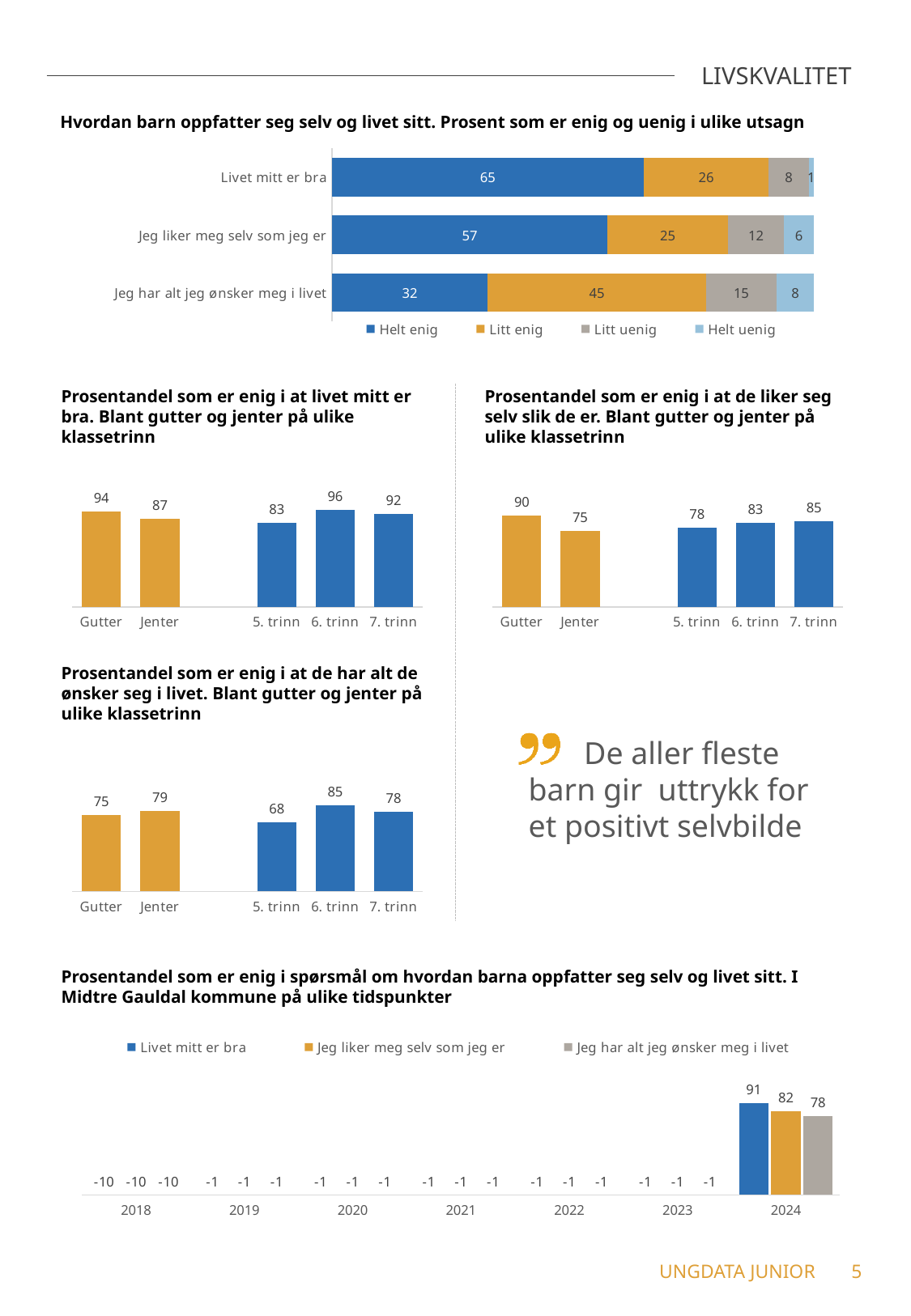
In the chart 'Prosentandel som er enig i at livet mitt er bra', which category has the highest value? 6. trinn In the top chart 'Hvordan barn oppfatter seg selv og livet sitt', what is the difference between the 'Helt enig' values for 'Livet mitt er bra' and 'Jeg liker meg selv som jeg er'? 8 In the chart 'Prosentandel som er enig i at de liker seg selv slik de er', which is larger, Gutter or Jenter? Gutter In the chart 'Prosentandel som er enig i at de har alt de ønsker seg i livet', what is the value for 6. trinn? 85 In the chart 'Prosentandel som er enig i at de liker seg selv slik de er', what is the difference between Gutter and Jenter? 15 In the chart 'Prosentandel som er enig i at livet mitt er bra', what is the value for Jenter? 87 In the bottom chart 'Prosentandel som er enig i spørsmål om hvordan barna oppfatter seg selv og livet sitt', what is the value for 'Livet mitt er bra' in 2024? 91 In the top chart 'Hvordan barn oppfatter seg selv og livet sitt', how many series does the legend list? 4 In the chart 'Prosentandel som er enig i at de har alt de ønsker seg i livet', which category has the lowest value? 5. trinn In the top chart 'Hvordan barn oppfatter seg selv og livet sitt', what percentage answered 'Litt enig' to 'Jeg har alt jeg ønsker meg i livet'? 45 What kind of chart is the top chart 'Hvordan barn oppfatter seg selv og livet sitt'? Stacked bar chart In the top chart 'Hvordan barn oppfatter seg selv og livet sitt', what percentage answered 'Helt enig' to 'Livet mitt er bra'? 65